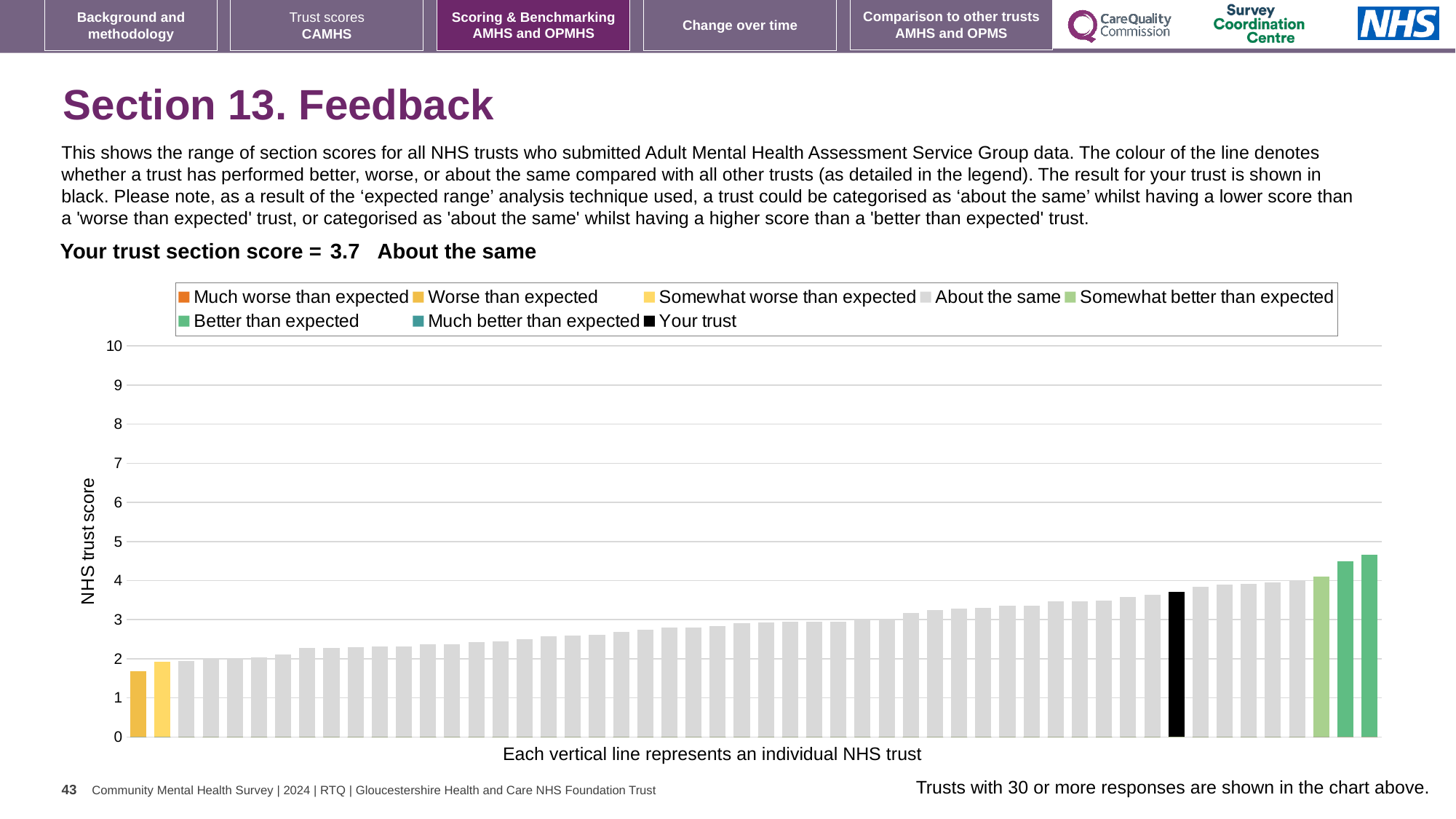
How many entries does the chart legend list? 8 Is the value of the black 'Your trust' bar greater or less than 4? less What is the label on the vertical axis of the chart? NHS trust score What is the section score for your trust shown on the slide? 3.7 What kind of chart is shown on the slide? bar chart How many bars are shown in a green colour (somewhat better or better than expected)? 3 Is the value of the black 'Your trust' bar greater or less than 3? greater Do the bar values rise or fall from left to right along the x axis? rise Is the value of the tallest bar greater or less than 5? less Which category is your trust placed in for this section? About the same Which is larger: the black 'Your trust' bar or the leftmost bar? Your trust